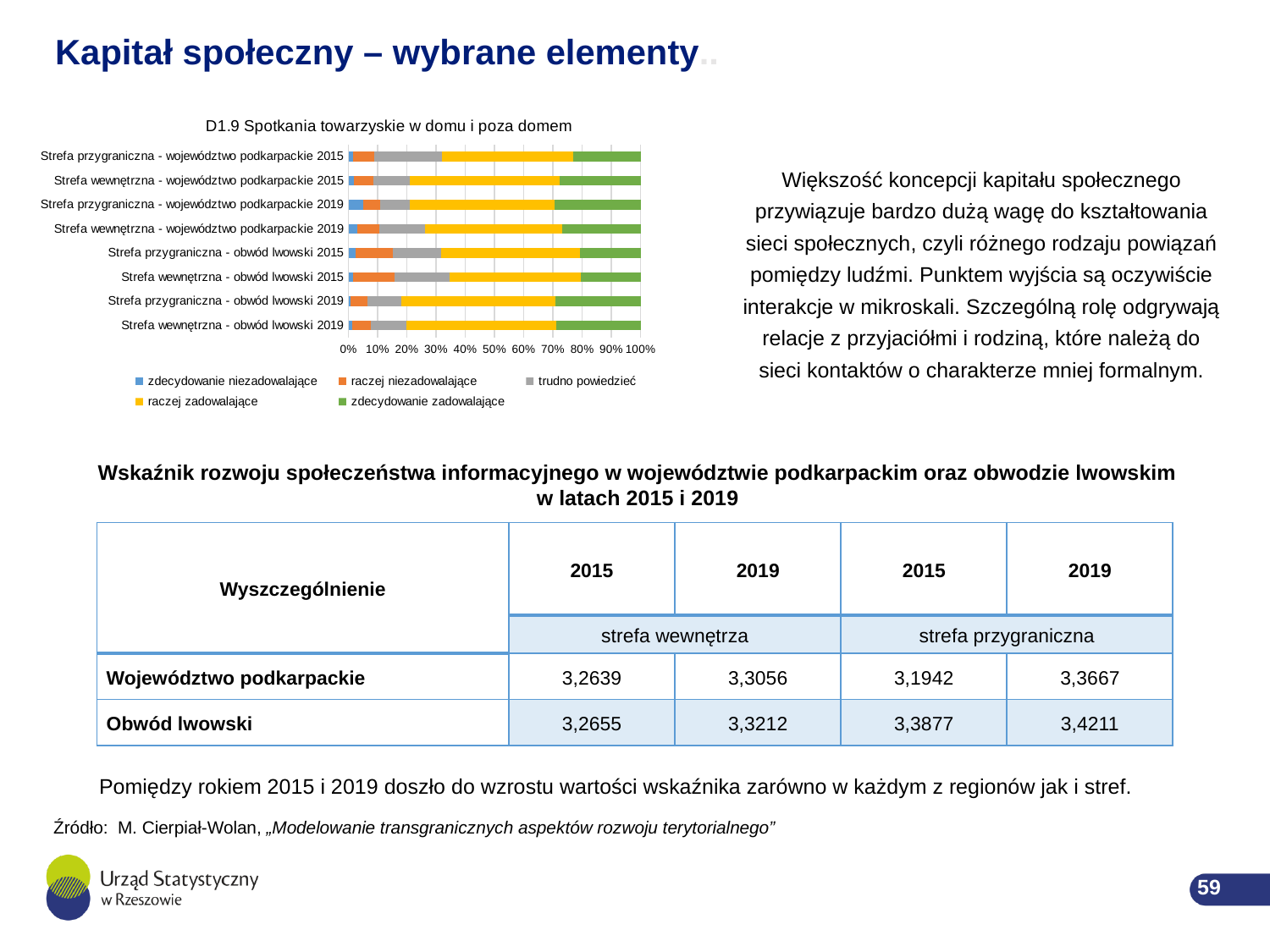
In the chart, is the "zdecydowanie zadowalające" share for "Strefa przygraniczna - obwód lwowski 2019" greater or less than 20%? greater What kind of chart is "D1.9 Spotkania towarzyskie w domu i poza domem"? Stacked bar chart In the chart, which has the larger "raczej niezadowalające" share: "Strefa przygraniczna - obwód lwowski 2015" or "Strefa przygraniczna - obwód lwowski 2019"? Strefa przygraniczna - obwód lwowski 2015 In the chart, is the "zdecydowanie zadowalające" share for "Strefa wewnętrzna - obwód lwowski 2019" greater or less than 20%? greater In the chart, is the "raczej niezadowalające" share for "Strefa przygraniczna - obwód lwowski 2015" greater or less than 20%? less How many categories (bars) are shown in the chart "D1.9 Spotkania towarzyskie w domu i poza domem"? 8 How many series does the legend of the chart "D1.9 Spotkania towarzyskie w domu i poza domem" list? 5 What is the title of the chart on the slide? D1.9 Spotkania towarzyskie w domu i poza domem Which legend entry in the chart is shown in grey? trudno powiedzieć In the chart, which has the larger "zdecydowanie zadowalające" share: "Strefa przygraniczna - obwód lwowski 2015" or "Strefa przygraniczna - obwód lwowski 2019"? Strefa przygraniczna - obwód lwowski 2019